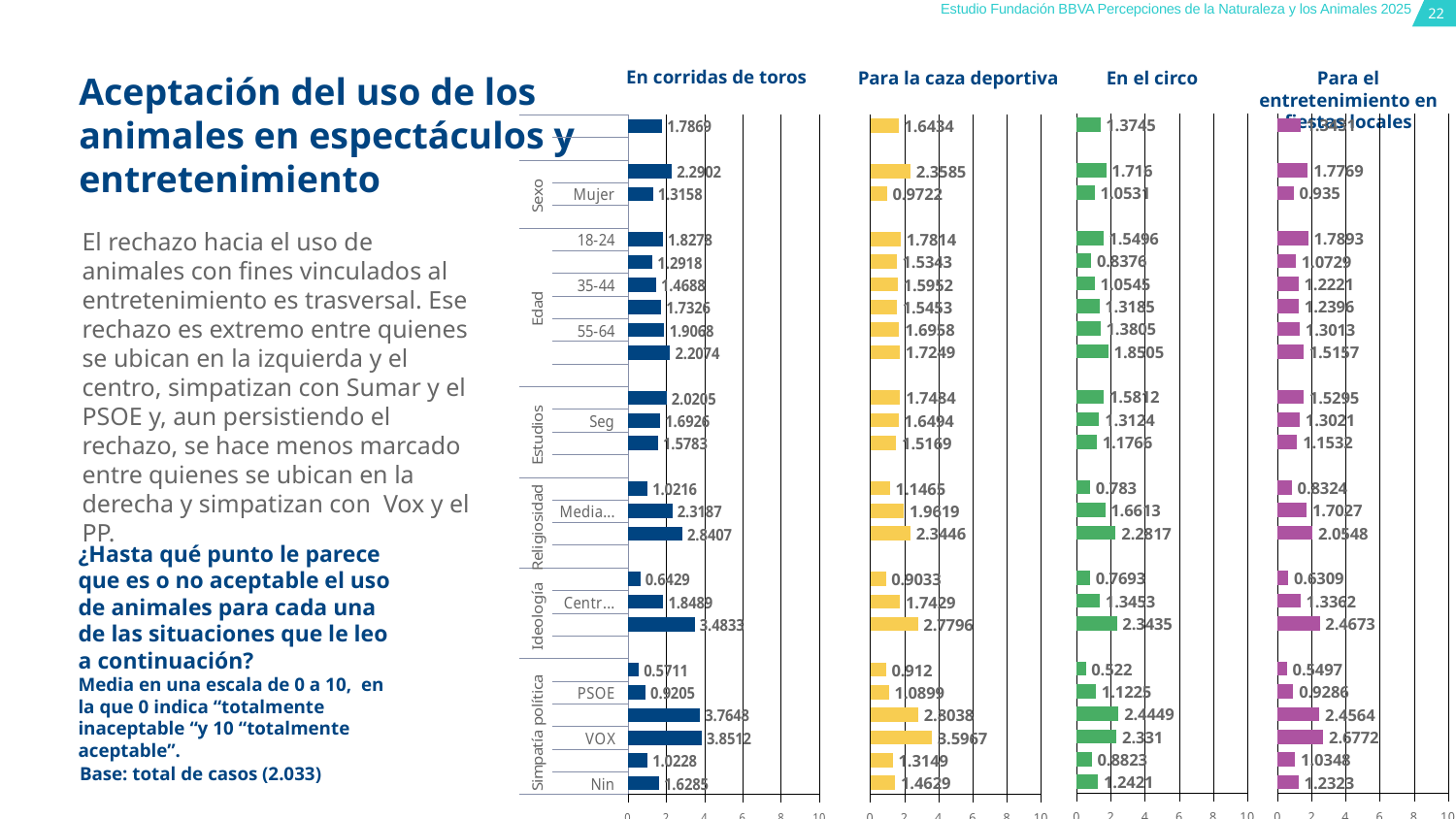
In the 'En corridas de toros' chart, what is the difference between the values for VOX and PSOE? 2.9307 In the 'Para la caza deportiva' chart, what is the value for Mujer? 0.9722 Which is larger: the value for Mujer in the 'En corridas de toros' chart or in the 'Para la caza deportiva' chart? En corridas de toros What kind of chart is used on this slide? Bar chart In the 'En el circo' chart, what is the value for 55-64? 1.3805 In the 'Para la caza deportiva' chart, is the value for VOX greater or less than 2? greater In the 'En corridas de toros' chart, which category has the highest value? VOX In the 'Para la caza deportiva' chart, which category has the highest value? VOX How many charts are shown on the slide? 4 In the 'En corridas de toros' chart, what is the value for VOX? 3.8512 In the 'Para el entretenimiento en fiestas locales' chart, what is the value for 18-24? 1.7893 In the 'En el circo' chart, what is the value for PSOE? 1.1225